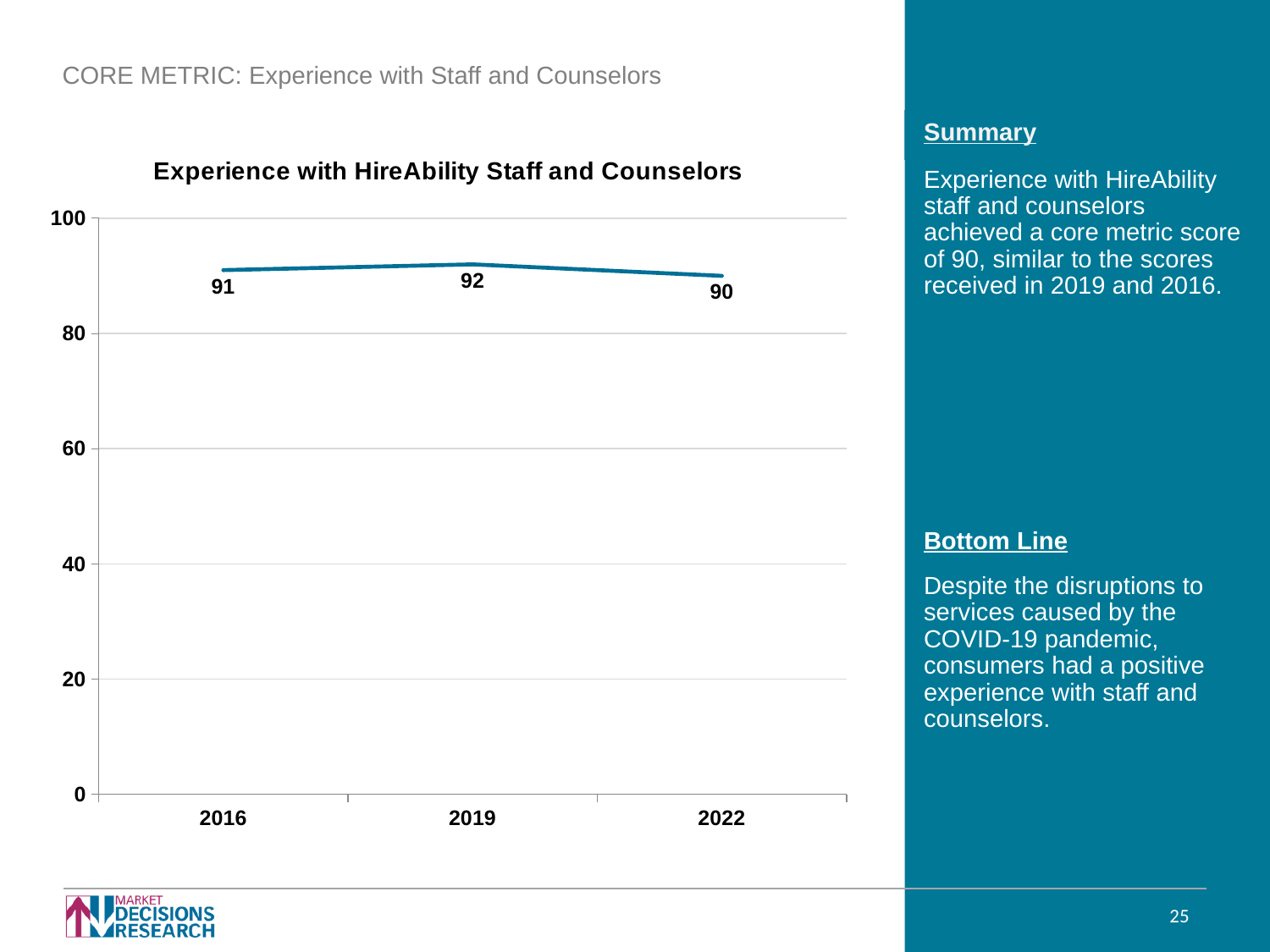
What is the difference between the values for 2019 and 2022? 2 What is the value for 2016? 91 Which is larger, the value for 2016 or the value for 2022? 2016 How many years are plotted on the chart? 3 Which year has the highest value? 2019 Which year has the lowest value? 2022 What is the value for 2019? 92 Is the value for 2022 greater or less than 80? greater What is the value for 2022? 90 Does the value rise or fall from 2019 to 2022? fall What is the title of the chart? Experience with HireAbility Staff and Counselors What kind of chart is shown? line chart